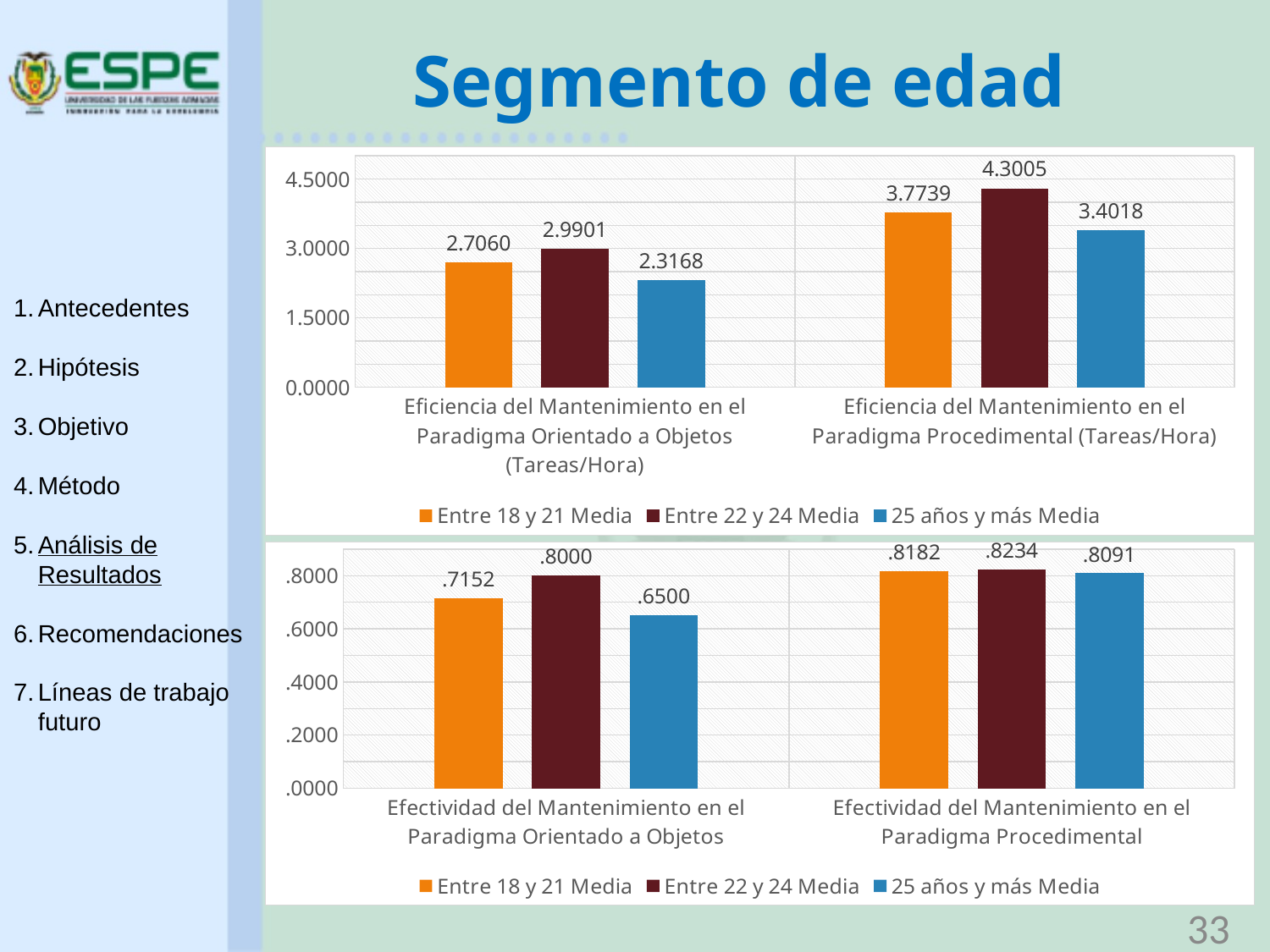
In the bottom chart, what is the value for 'Entre 18 y 21 Media' in 'Efectividad del Mantenimiento en el Paradigma Procedimental'? .8182 In the top chart, which is larger: 'Entre 18 y 21 Media' in the Procedimental category or 'Entre 22 y 24 Media' in the Orientado a Objetos category? Entre 18 y 21 Media in the Procedimental category In the bottom chart, what is the difference between 'Entre 22 y 24 Media' and 'Entre 18 y 21 Media' in 'Efectividad del Mantenimiento en el Paradigma Orientado a Objetos'? .0848 In the top chart, what is the value for 'Entre 22 y 24 Media' in 'Eficiencia del Mantenimiento en el Paradigma Procedimental (Tareas/Hora)'? 4.3005 What kind of chart is the bottom chart? Bar chart In the bottom chart, which series has the lowest value in 'Efectividad del Mantenimiento en el Paradigma Orientado a Objetos'? 25 años y más Media In the top chart, which series has the highest value in 'Eficiencia del Mantenimiento en el Paradigma Orientado a Objetos (Tareas/Hora)'? Entre 22 y 24 Media In the top chart, what is the difference between the 'Entre 22 y 24 Media' values for the Procedimental and Orientado a Objetos categories? 1.3104 In the top chart, what is the value for '25 años y más Media' in 'Eficiencia del Mantenimiento en el Paradigma Orientado a Objetos (Tareas/Hora)'? 2.3168 How many series does the legend of the top chart list? 3 How many categories are shown on the x axis of the bottom chart? 2 In the bottom chart, what is the value for '25 años y más Media' in 'Efectividad del Mantenimiento en el Paradigma Orientado a Objetos'? .6500